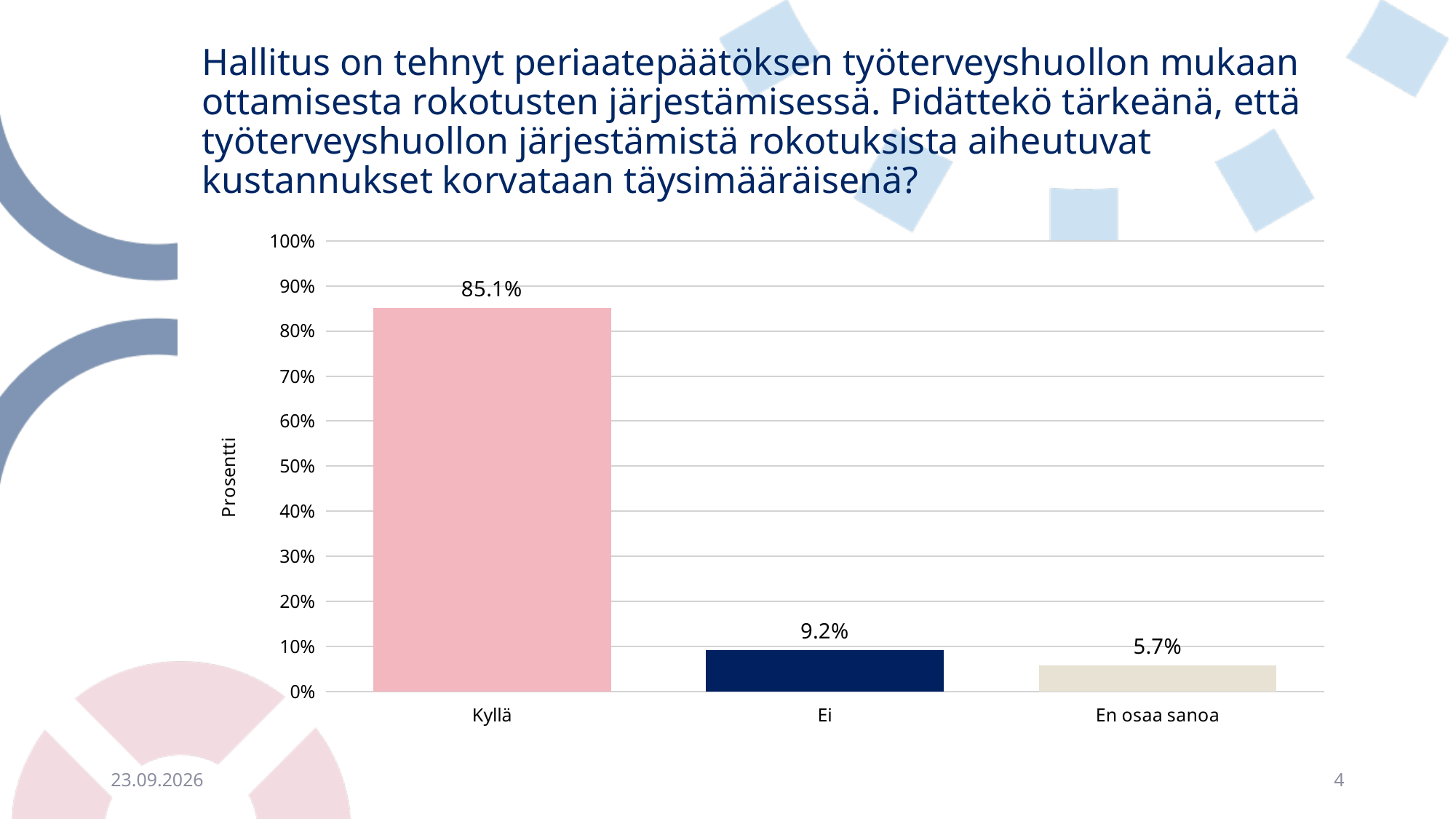
What is the difference between the values for Ei and En osaa sanoa? 3.5% What is the value for Ei? 9.2% Which is larger, the value for Ei or the value for En osaa sanoa? Ei Is the value for Kyllä greater or less than 80%? greater What is the value for En osaa sanoa? 5.7% Which category has the lowest value? En osaa sanoa How many categories are shown on the x axis? 3 Which category has the highest value? Kyllä What is the value for Kyllä? 85.1% What kind of chart is shown on the slide? bar chart What is the label of the vertical axis? Prosentti What is the difference between the values for Kyllä and Ei? 75.9%